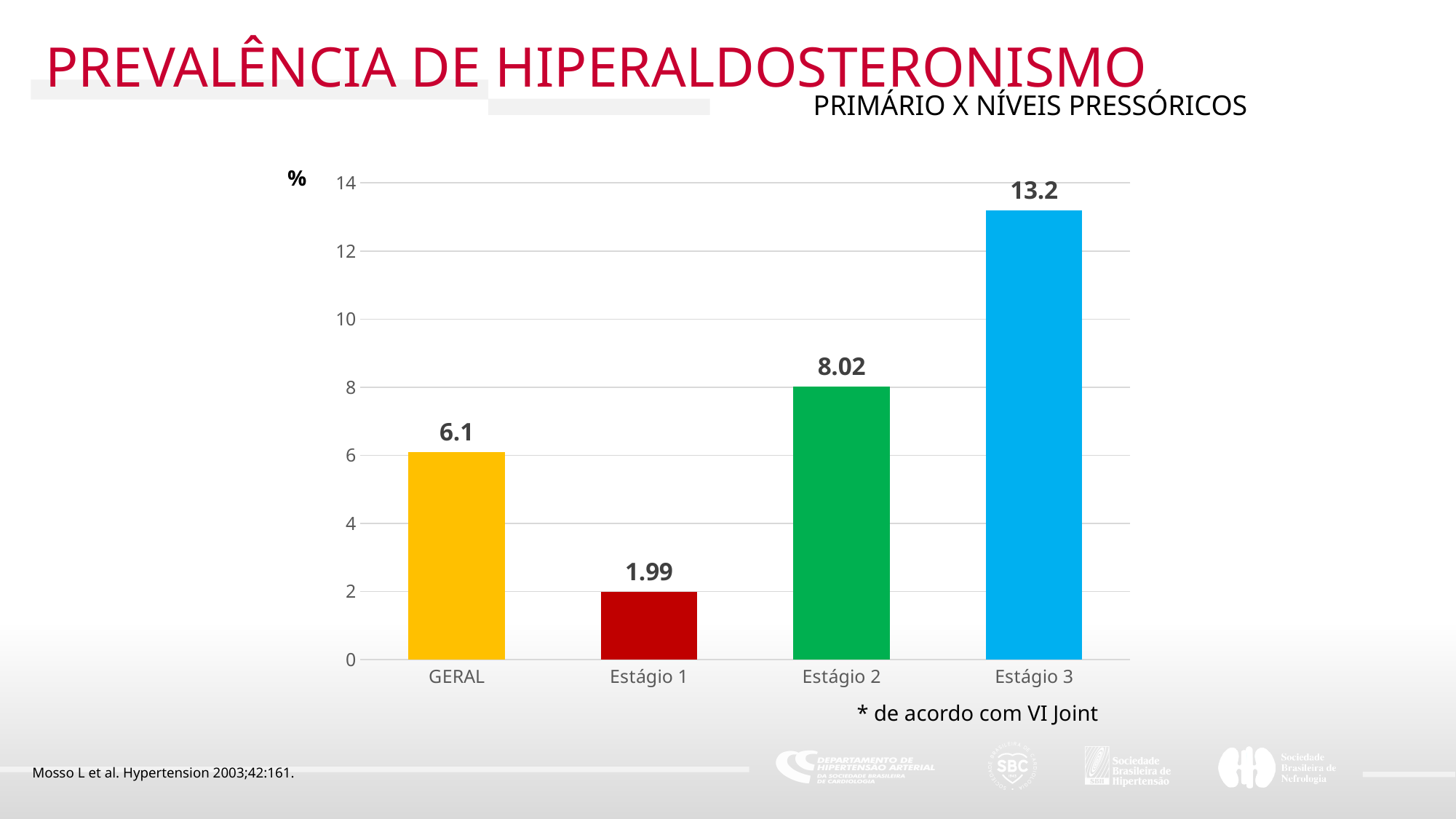
Which category has the highest value? Estágio 3 What unit is shown on the y axis label? % Which is larger, the value for GERAL or the value for Estágio 2? Estágio 2 What is the difference between the values for Estágio 3 and Estágio 2? 5.18 What is the value for Estágio 2? 8.02 How many categories are shown on the x axis? 4 Which category has the lowest value? Estágio 1 What is the value for Estágio 1? 1.99 What kind of chart is shown on the slide? bar chart Is the value for Estágio 3 greater or less than 12? greater What is the value for Estágio 3? 13.2 What is the value for GERAL? 6.1